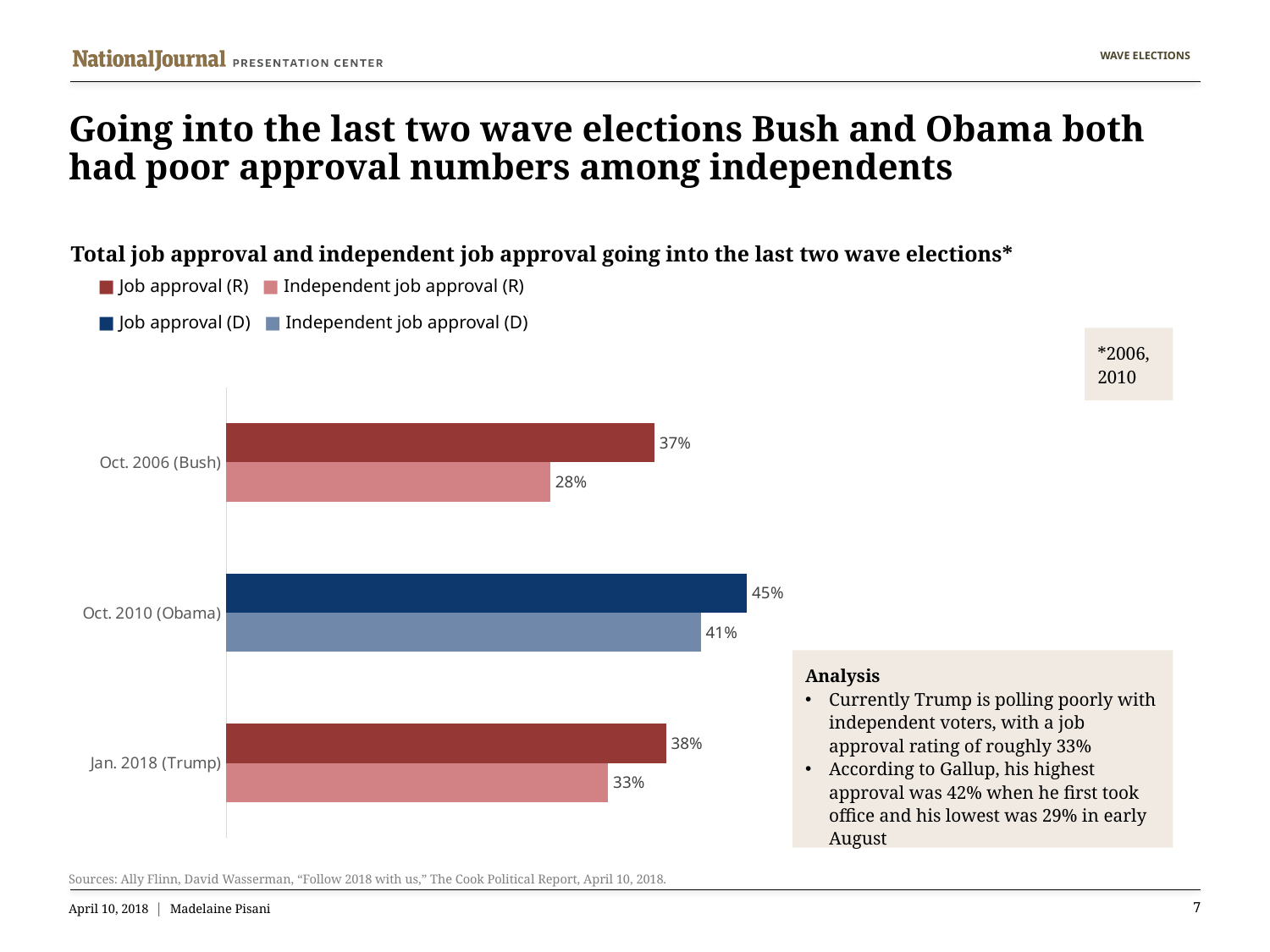
Which is larger: the independent job approval for Oct. 2010 (Obama) or the job approval for Jan. 2018 (Trump)? Independent job approval for Oct. 2010 (Obama) Which category has the lowest independent job approval value? Oct. 2006 (Bush) What is the difference between job approval and independent job approval for Oct. 2010 (Obama)? 4% How many categories are shown on the chart? 3 What is the difference between job approval and independent job approval for Oct. 2006 (Bush)? 9% Which category has the highest job approval value? Oct. 2010 (Obama) What is the job approval value for Oct. 2006 (Bush)? 37% What is the independent job approval value for Jan. 2018 (Trump)? 33% What is the independent job approval value for Oct. 2006 (Bush)? 28% What is the job approval value for Oct. 2010 (Obama)? 45% How many series does the legend list? 4 What kind of chart is shown on the slide? Bar chart